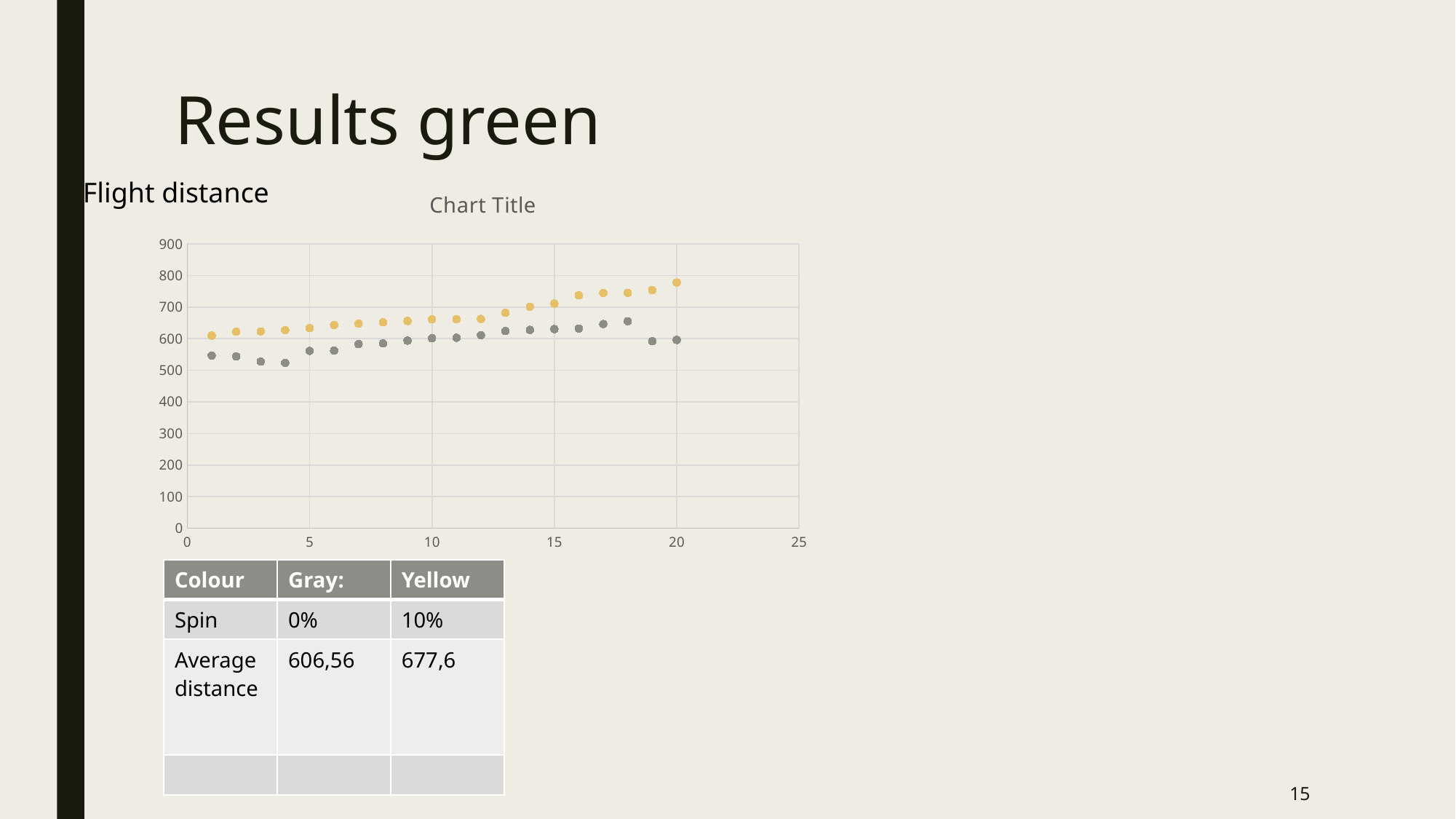
At x = 10, which series has the higher value, yellow or gray? yellow How many points does the yellow series have? 20 At which x value does the yellow series reach its highest point? 20 Is the value of the yellow series at x = 1 greater or less than 700? less Do the values of the yellow series rise or fall as x increases? rise Is the value of the gray series at x = 18 greater or less than 600? greater What is the highest value shown on the vertical axis? 900 Is the value of the yellow series at x = 20 greater or less than 700? greater What kind of chart is shown on the slide? scatter chart How many series of points are plotted on the chart? 2 What is the title printed above the chart? Chart Title